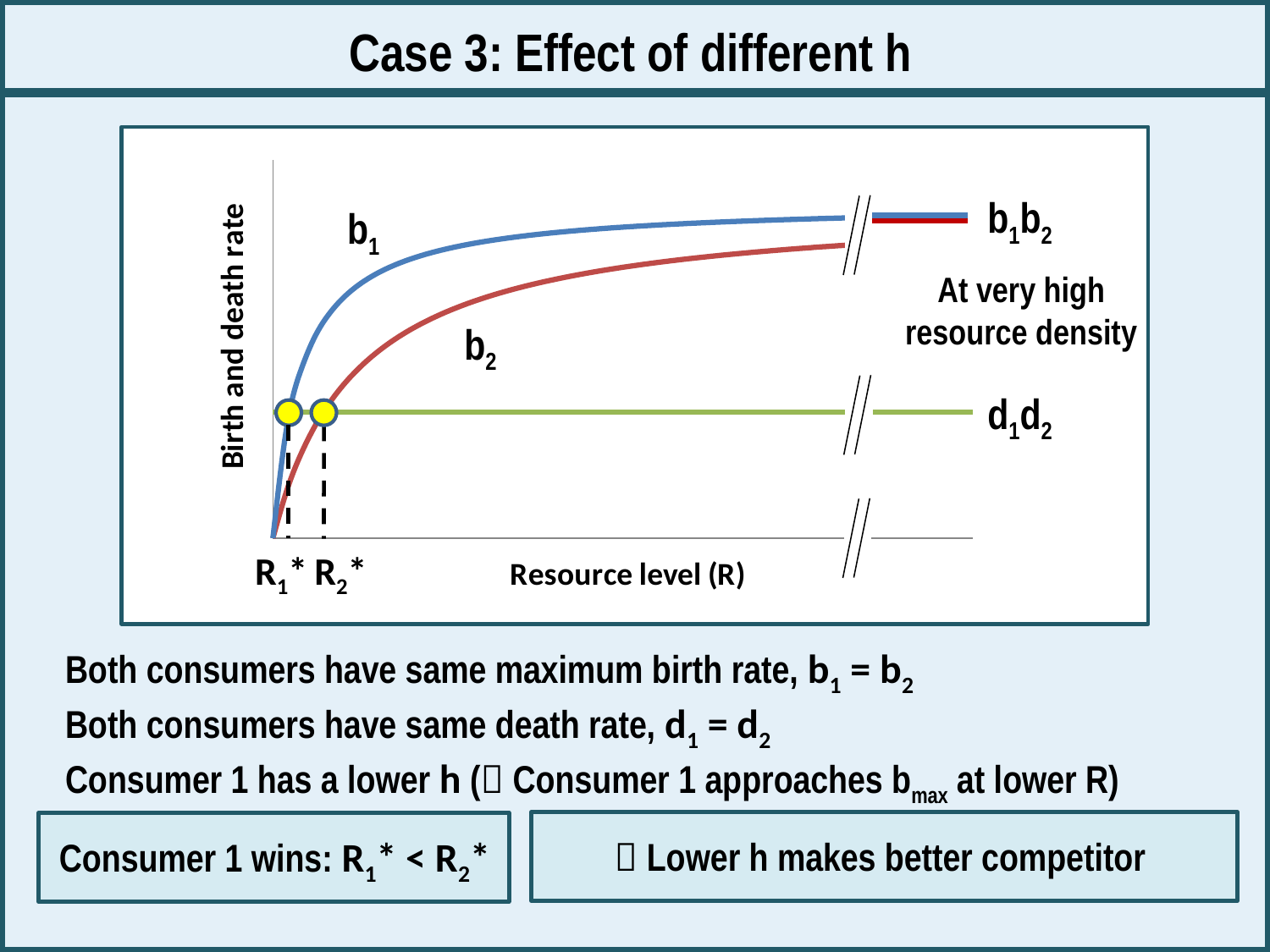
At very high resource density, do the curves b1 and b2 converge to the same value or remain separated? converge to the same value What kind of chart is shown on the slide? line chart Which curve lies above the other at intermediate resource levels, b1 or b2? b1 How many yellow marked points are shown where the birth curves cross the death rate line? 2 How many birth rate curves are plotted on the chart? 2 What is the label of the x axis of the chart? Resource level (R) Which is larger on the x axis, R1* or R2*? R2* Does the death rate line d1d2 rise, fall, or stay flat as the resource level increases? stay flat What is the label of the y axis of the chart? Birth and death rate Do the birth rate curves b1 and b2 rise or fall as the resource level increases? rise